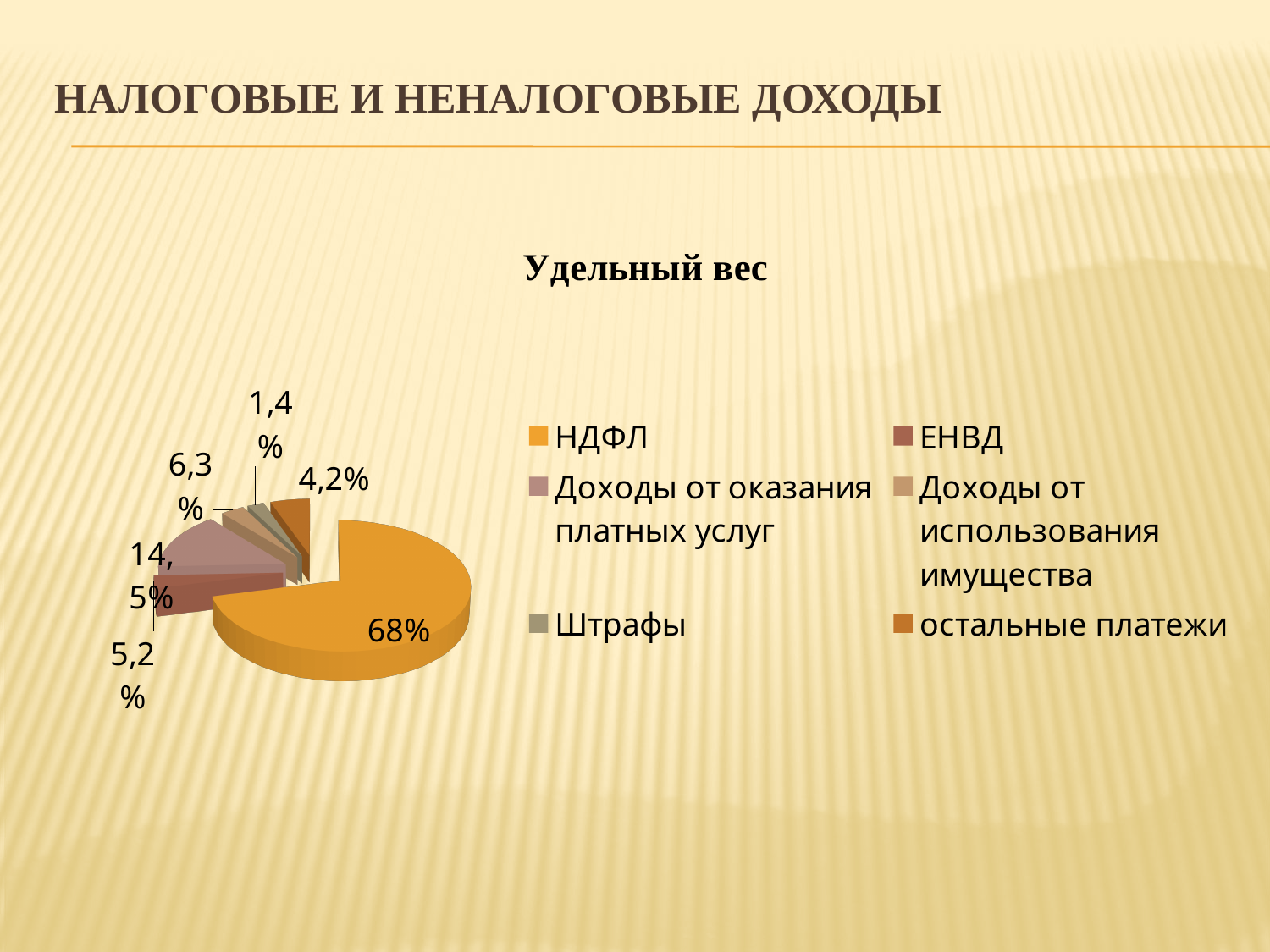
What share of the pie does ЕНВД have? 5,2% What share of the pie does Доходы от использования имущества have? 6,3% How many categories does the legend of the pie chart list? 6 What share of the pie does НДФЛ have? 68% What type of chart is shown on the slide? pie chart Which category has the smallest slice of the pie? Штрафы Which category has the largest slice of the pie? НДФЛ Which is larger: the slice for Доходы от оказания платных услуг or the slice for ЕНВД? Доходы от оказания платных услуг What share of the pie does Доходы от оказания платных услуг have? 14,5% What is the title of the chart? Удельный вес What share of the pie does остальные платежи have? 4,2% What share of the pie does Штрафы have? 1,4%